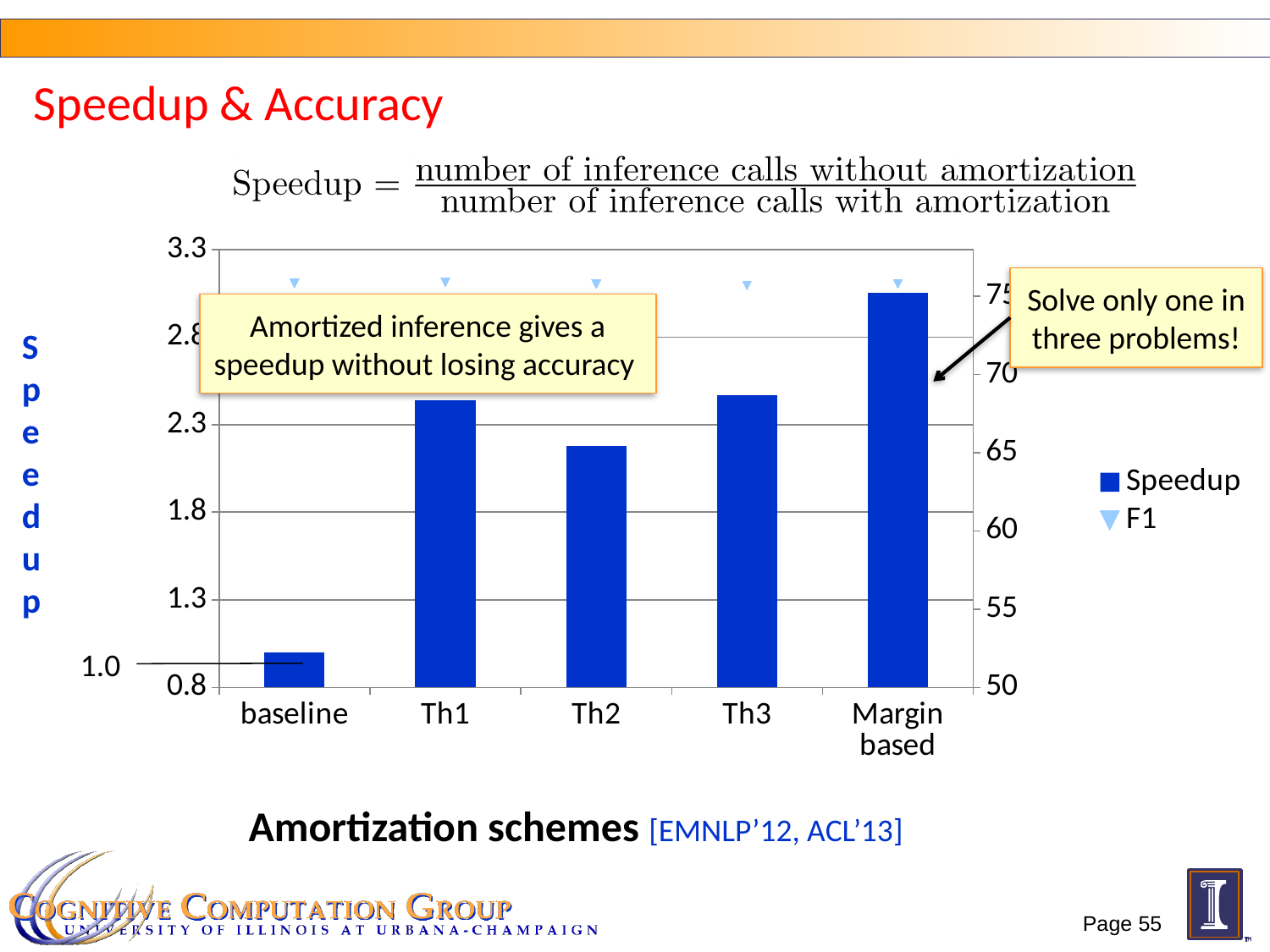
Which amortization scheme has the lowest speedup? baseline Which amortization scheme has the highest speedup? Margin based Is the speedup for Margin based greater or less than 2.8? greater Which has a larger speedup, Th1 or Th2? Th1 Which has a larger speedup, Margin based or Th3? Margin based Is the speedup for Th1 greater or less than 2.3? greater Is the speedup for Th2 greater or less than 2.3? less What is the speedup value for the baseline? 1.0 How many series does the legend list? 2 How many amortization schemes (categories) are shown on the x axis? 5 What kind of chart is shown on the slide? bar chart What are the two series named in the legend? Speedup and F1